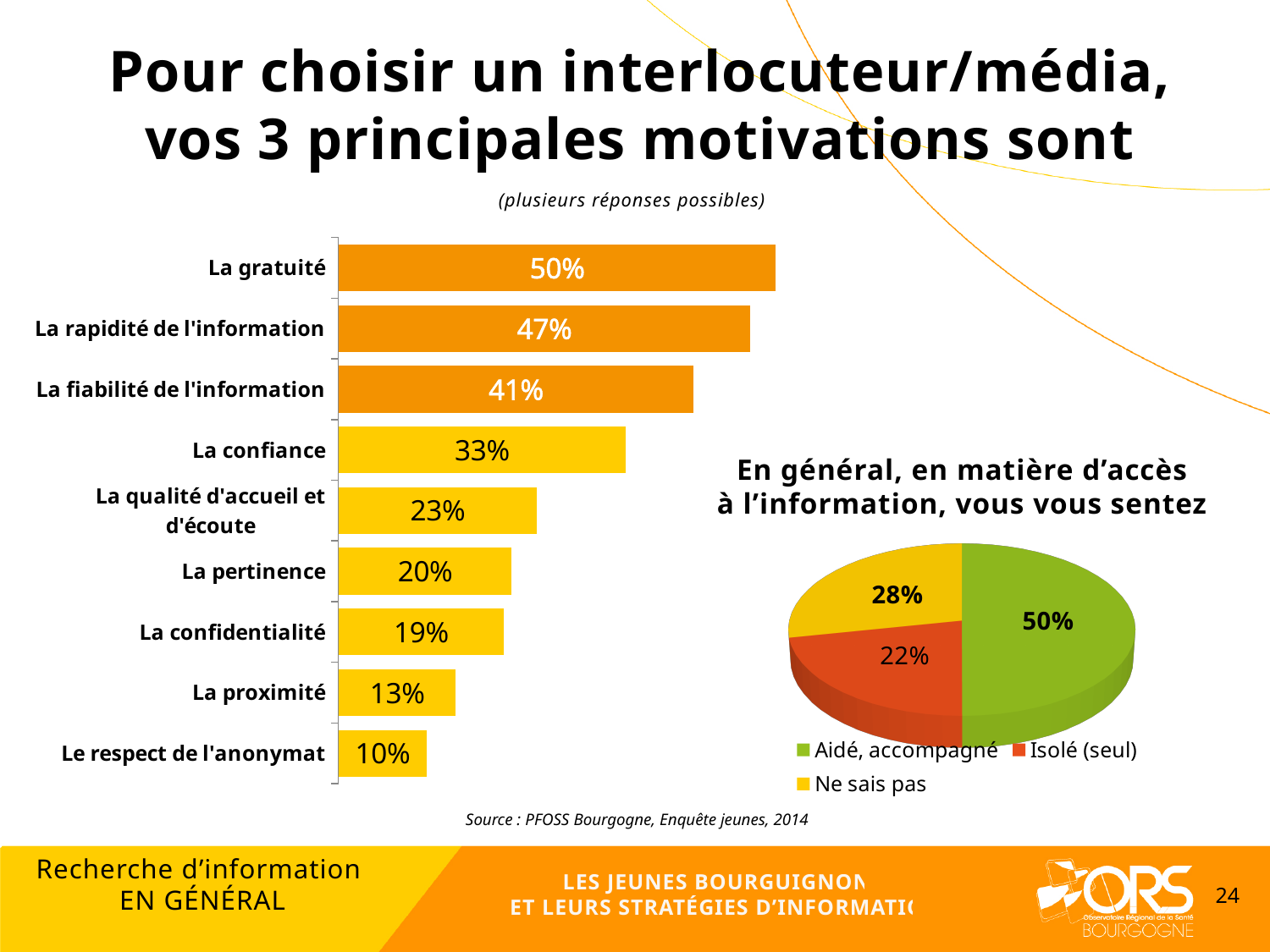
In the bar chart on the left, which is larger: La confiance or La pertinence? La confiance In the pie chart on the right, what is the difference between Ne sais pas and Isolé (seul)? 6% How many entries does the legend of the pie chart on the right list? 3 In the bar chart on the left, which category has the lowest value? Le respect de l'anonymat In the bar chart on the left, what is the value for La confidentialité? 19% In the bar chart on the left, what is the value for La gratuité? 50% In the pie chart titled 'En général, en matière d'accès à l'information, vous vous sentez', what share is Isolé (seul)? 22% In the pie chart titled 'En général, en matière d'accès à l'information, vous vous sentez', which slice is the largest? Aidé, accompagné In the bar chart on the left, which category has the highest value? La gratuité How many categories does the bar chart on the left show? 9 What kind of chart is the chart on the left of the slide? Bar chart In the bar chart on the left, what is the difference between La rapidité de l'information and La fiabilité de l'information? 6%